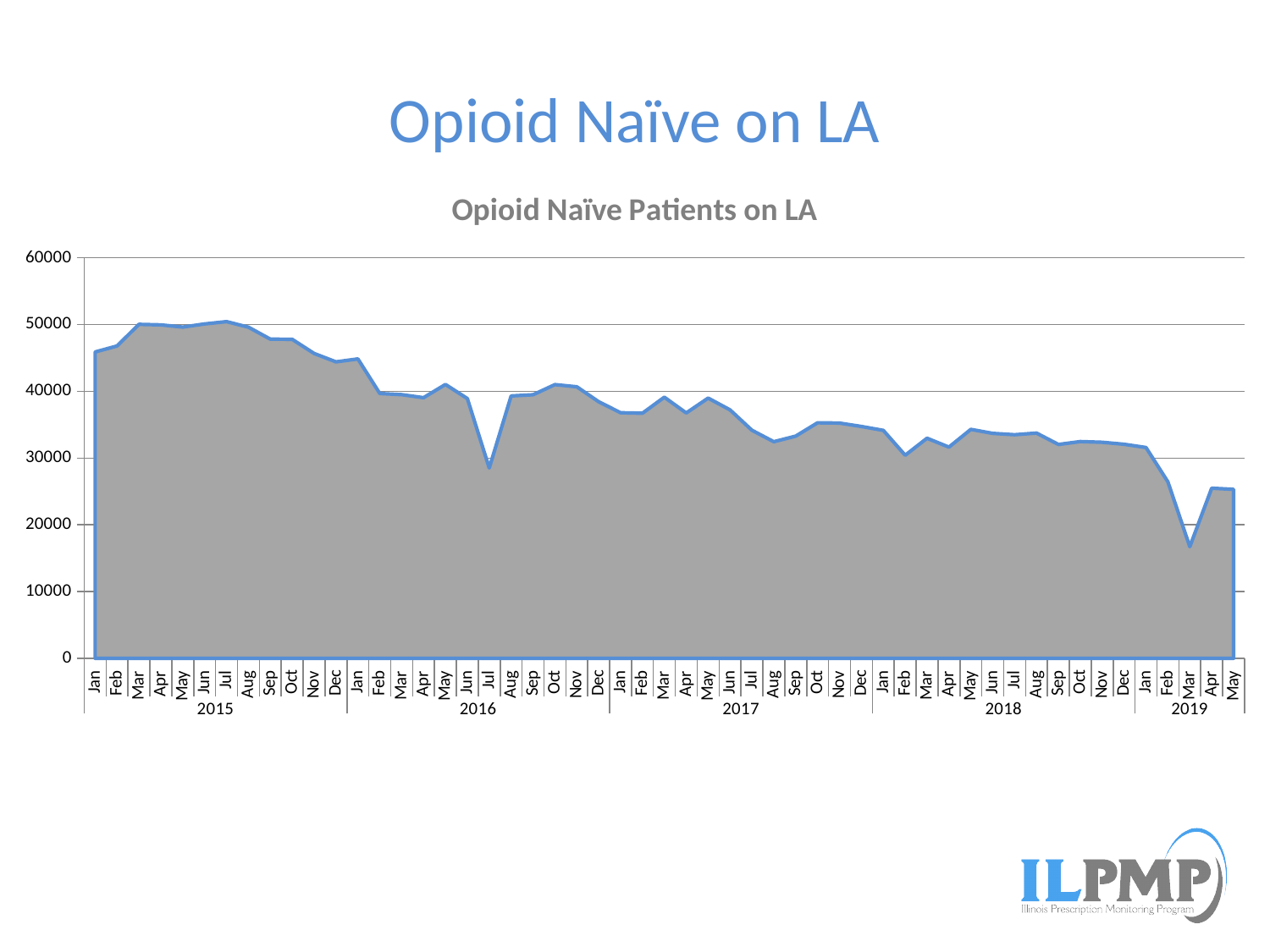
Is the value for Jan 2018 greater or less than 30000? greater Which is larger, the value for Jul 2016 or the value for Jul 2017? Jul 2017 Is the value for Jan 2017 greater or less than 40000? less How many monthly data points are plotted in the chart? 53 What kind of chart is shown on the slide? Area chart Which is larger, the value for Jan 2015 or the value for Jan 2019? Jan 2015 Is the value for Jul 2016 greater or less than 30000? less Which month has the lowest value in the chart? Mar 2019 Overall, do the values rise or fall from Jan 2015 to May 2019? Fall What is the title of the chart? Opioid Naïve Patients on LA